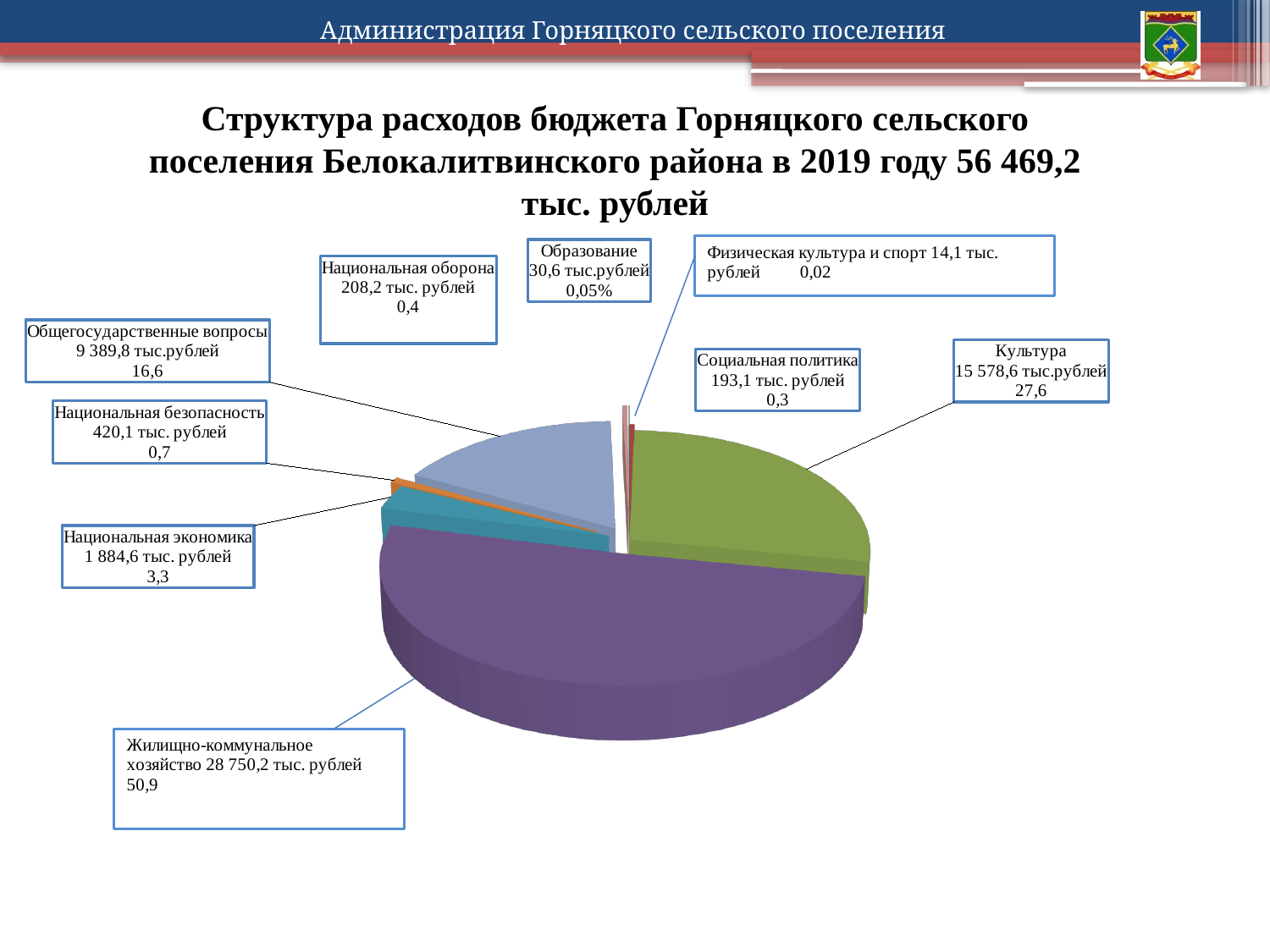
What type of chart is shown on the slide? Pie chart What share of the budget expenditures does Общегосударственные вопросы account for? 16,6 What is the total budget expenditure stated in the chart title? 56 469,2 тыс. рублей How many expenditure categories are shown in the pie chart? 9 What share of the budget expenditures does Жилищно-коммунальное хозяйство account for? 50,9 Which category has the largest expenditure? Жилищно-коммунальное хозяйство What is the amount for Национальная экономика? 1 884,6 тыс. рублей Which category has the smallest expenditure? Физическая культура и спорт Which is larger: the amount for Национальная безопасность or Национальная оборона? Национальная безопасность What is the amount for Культура? 15 578,6 тыс.рублей What is the amount for Жилищно-коммунальное хозяйство? 28 750,2 тыс. рублей What is the difference between the amounts for Жилищно-коммунальное хозяйство and Культура? 13 171,6 тыс. рублей